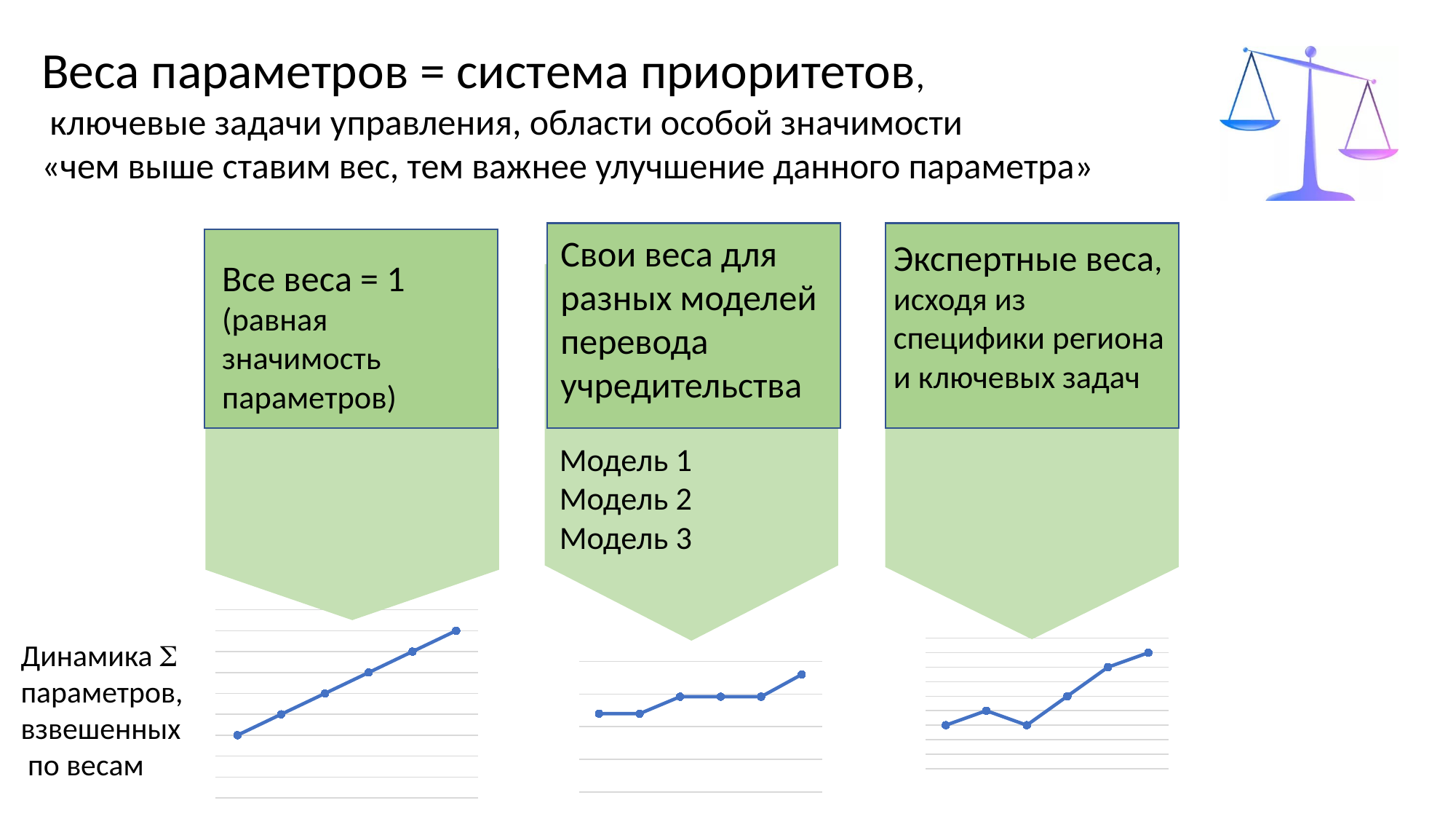
On the left chart, which point is the highest: the first or the last? the last On the left chart, do the values rise or fall from left to right? rise On the right chart, is the third point higher or lower than the second point? lower What kind of chart is the middle chart at the bottom of the slide? line chart How many lines are plotted on the middle chart? 1 How many data points are plotted on the right chart? 6 What kind of chart is the right chart at the bottom of the slide? line chart On the right chart, do the values overall rise or fall from left to right? rise What kind of chart is the left chart at the bottom of the slide? line chart On the middle chart, is the last point higher or lower than the first point? higher How many data points are plotted on the middle chart? 6 How many data points are plotted on the left chart? 6